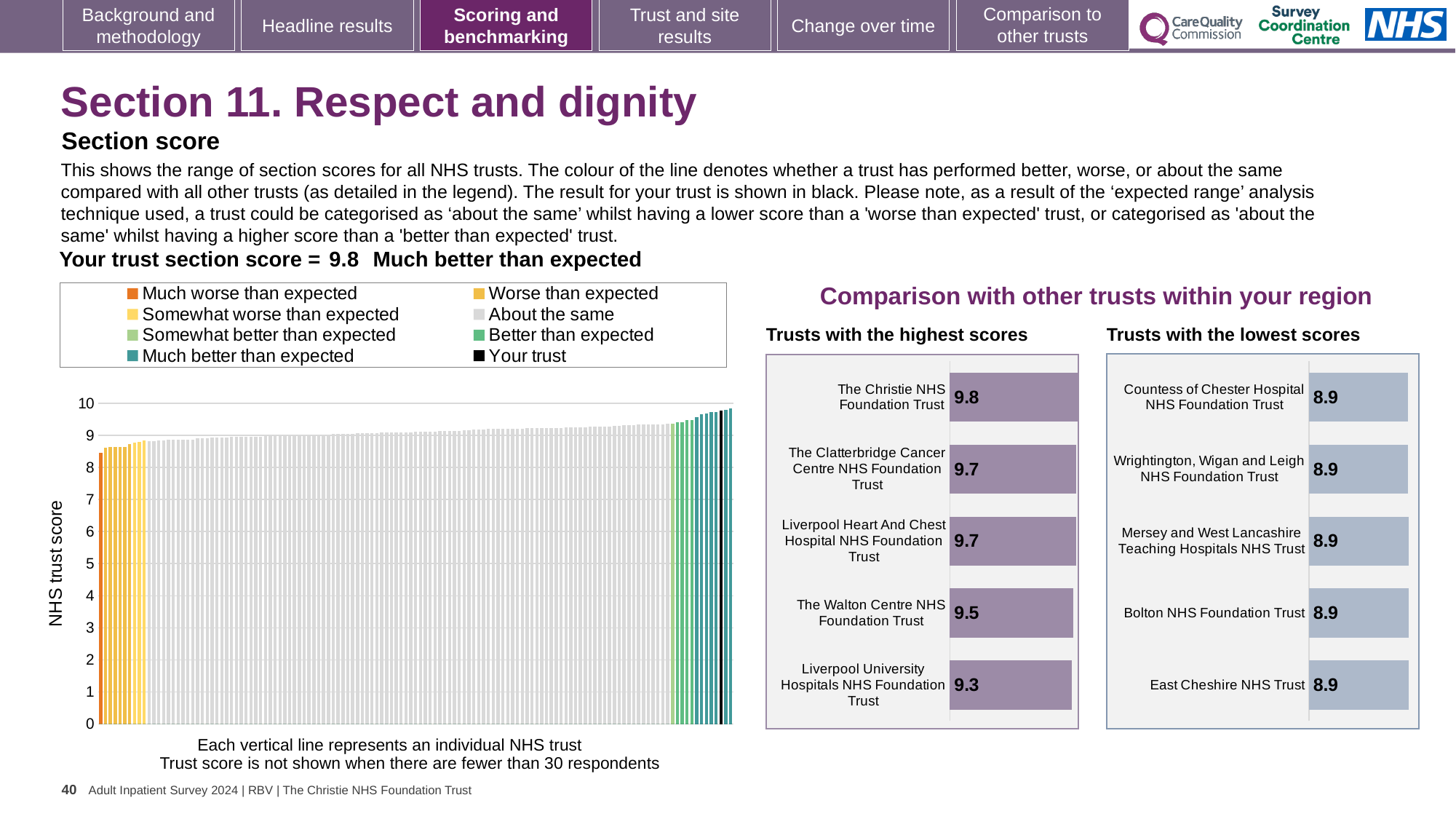
In the 'Trusts with the highest scores' chart, which has the larger score: The Walton Centre NHS Foundation Trust or The Clatterbridge Cancer Centre NHS Foundation Trust? The Clatterbridge Cancer Centre NHS Foundation Trust What type of chart is the large chart on the left showing the range of section scores for all NHS trusts? bar chart How many trusts are listed in the 'Trusts with the lowest scores' chart? 5 In the 'Trusts with the highest scores' chart, what is the difference between the scores of The Christie NHS Foundation Trust and Liverpool University Hospitals NHS Foundation Trust? 0.5 In the 'Trusts with the highest scores' chart, which trust has the highest score? The Christie NHS Foundation Trust In the 'Trusts with the highest scores' chart, what is the score for The Walton Centre NHS Foundation Trust? 9.5 In the left-hand section score chart, do the trust scores rise or fall from left to right? rise How many trusts are listed in the 'Trusts with the highest scores' chart? 5 How many entries does the legend of the left-hand section score chart list? 8 In the 'Trusts with the lowest scores' chart, what is the score for Bolton NHS Foundation Trust? 8.9 In the 'Trusts with the highest scores' chart, what is the score for The Christie NHS Foundation Trust? 9.8 In the 'Trusts with the highest scores' chart, which trust has the lowest score? Liverpool University Hospitals NHS Foundation Trust